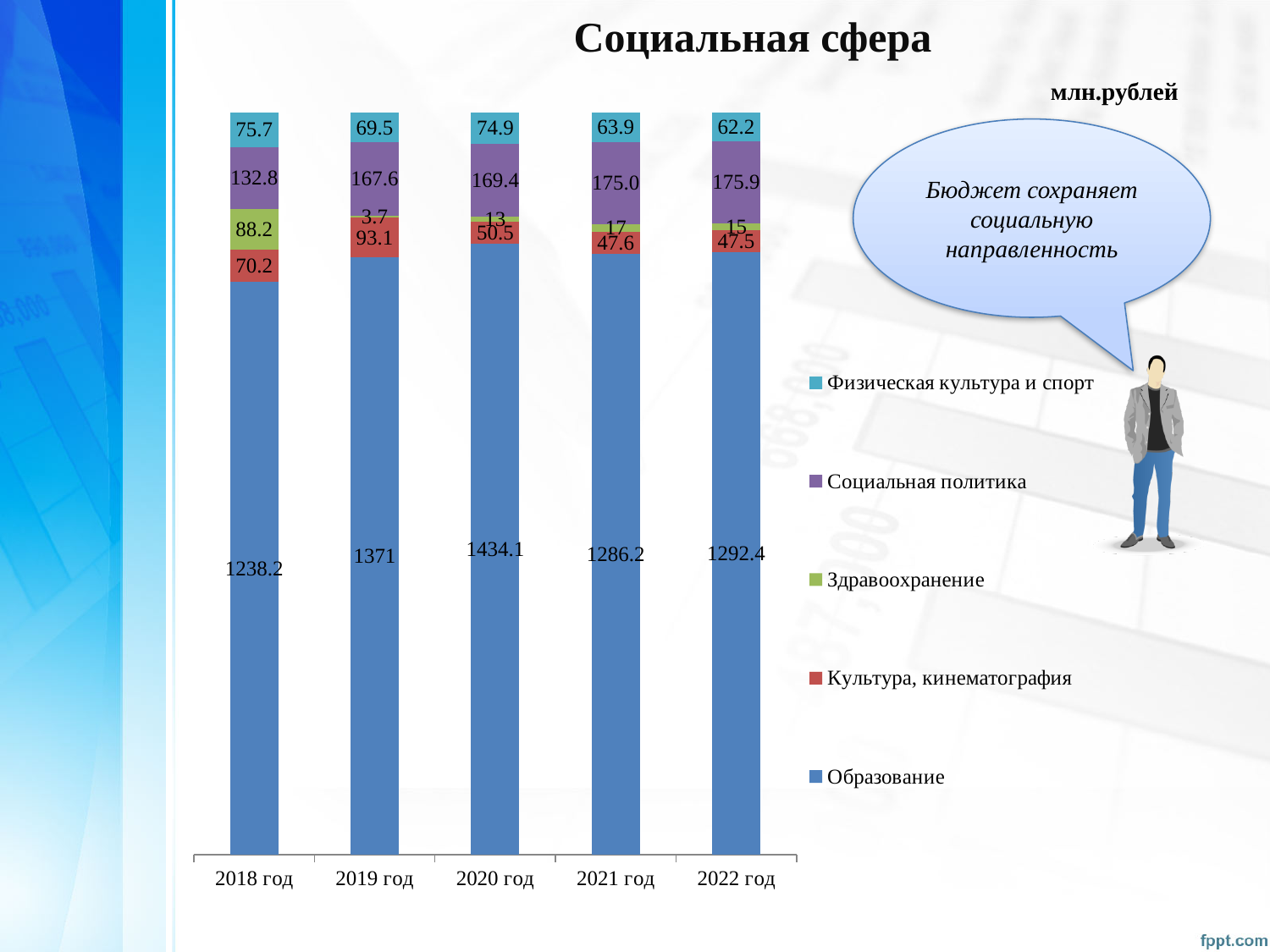
How many years are shown on the x axis? 5 How many series does the legend list? 5 What is the difference between the Социальная политика values for 2022 год and 2018 год? 43.1 What is the value for Физическая культура и спорт in 2022 год? 62.2 What is the total of the stacked bar for 2020 год? 1741.9 What is the value for Социальная политика in 2018 год? 132.8 What kind of chart is shown on the slide? Stacked bar chart What is the value for Образование in 2020 год? 1434.1 Which is larger: Культура, кинематография in 2019 год or in 2020 год? 2019 год In which year is the value for Здравоохранение the lowest? 2019 год In which year is the value for Образование the highest? 2020 год What is the value for Здравоохранение in 2019 год? 3.7